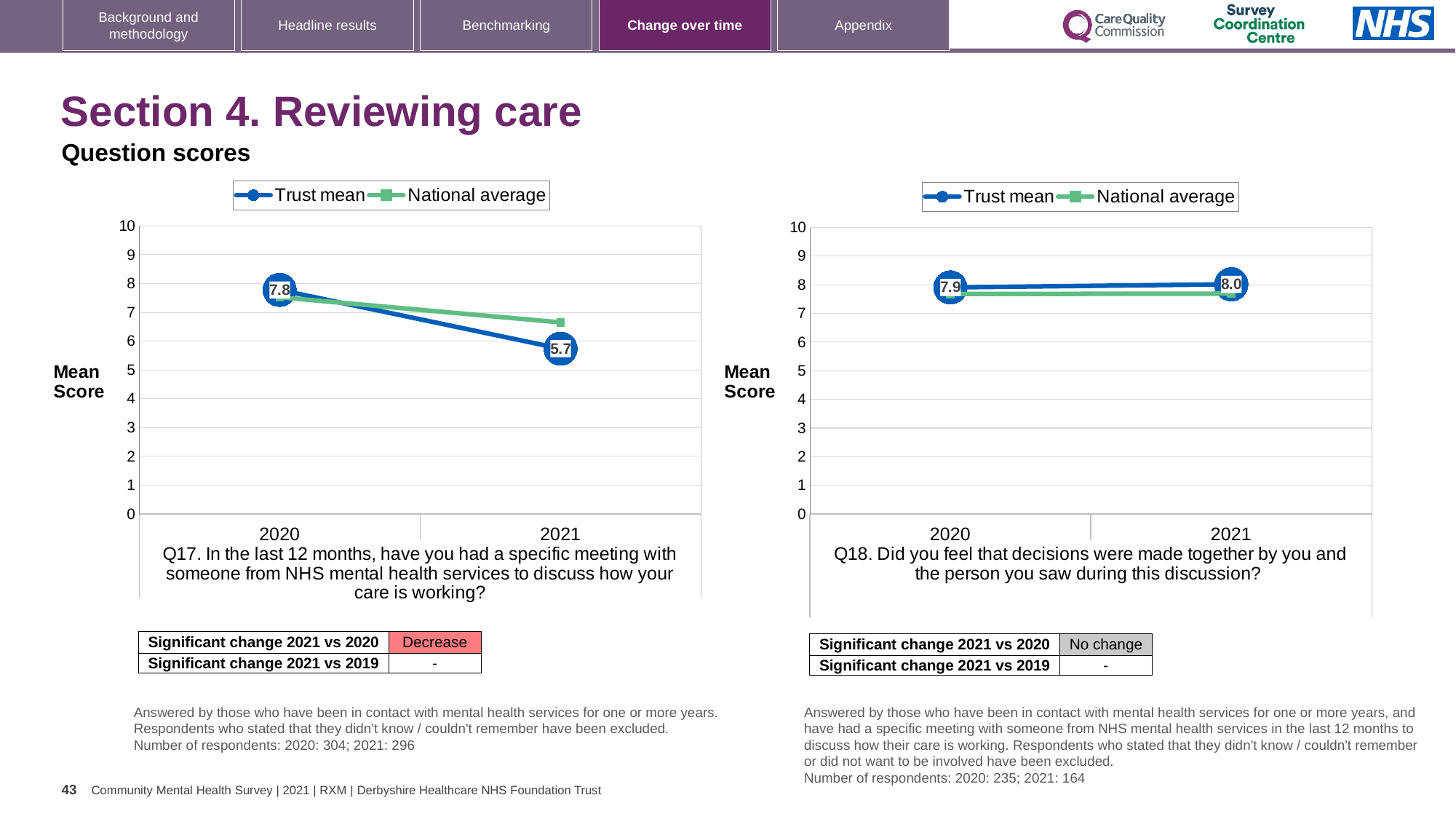
In the Q17 chart, which is larger in 2021, the Trust mean or the National average? National average How many years are plotted on the x axis of the Q18 chart? 2 In the Q18 chart, is the National average for 2020 greater or less than 7? greater In the Q17 chart, is the National average for 2021 greater or less than 6? greater What kind of chart is used for Q17? line chart In the Q18 chart, what is the Trust mean score for 2020? 7.9 In the Q17 chart, what is the Trust mean score for 2020? 7.8 In the Q17 chart, does the Trust mean rise or fall from 2020 to 2021? fall In the Q17 chart, what is the Trust mean score for 2021? 5.7 How many series does the legend of the Q18 chart list? 2 In the Q17 chart, by how much did the Trust mean fall from 2020 to 2021? 2.1 In the Q18 chart, what is the Trust mean score for 2021? 8.0